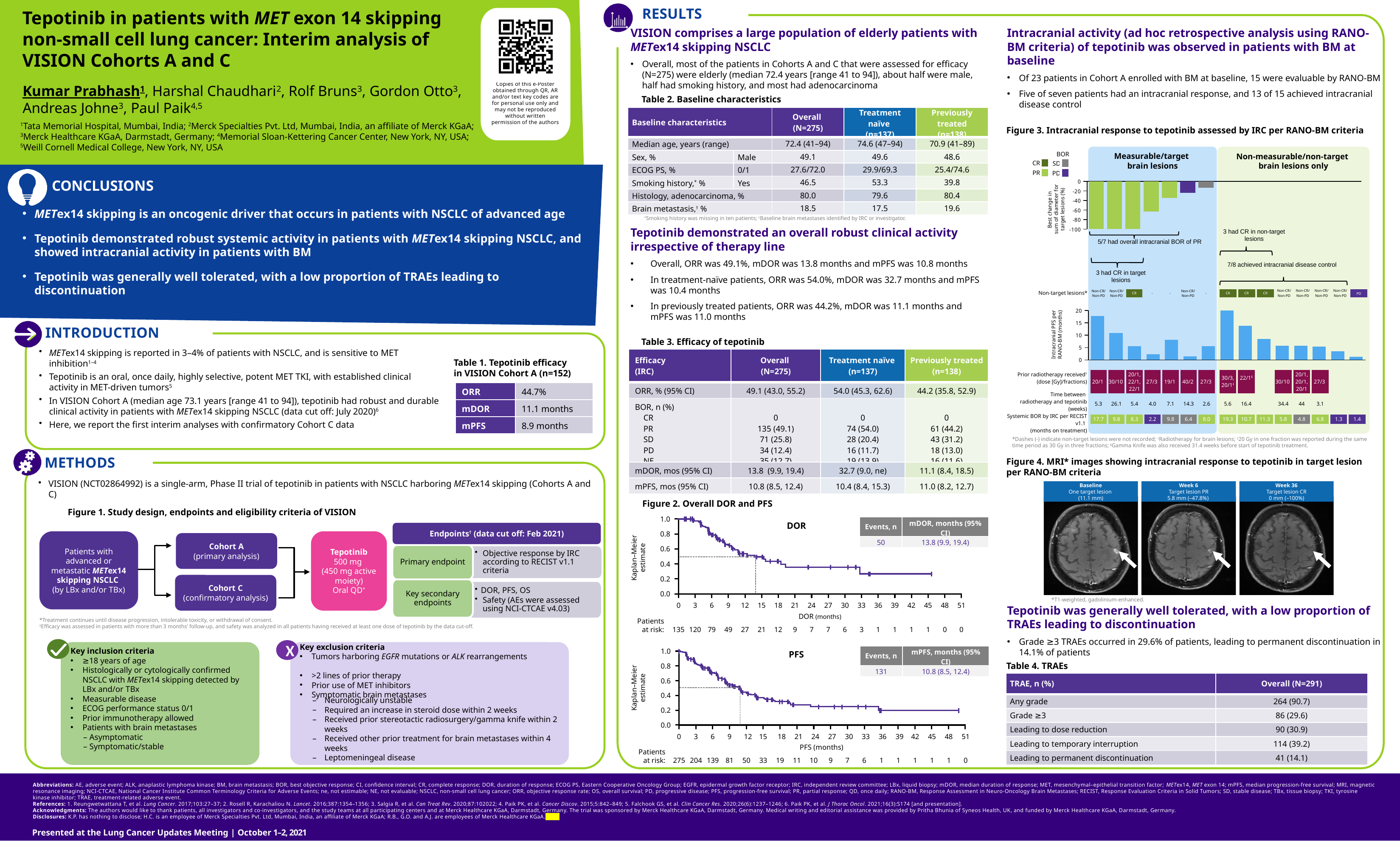
In Figure 2, how many events (n) are reported for the DOR curve? 50 In Figure 3, how many BOR categories does the legend list? 4 In Figure 2, does the PFS Kaplan-Meier estimate rise or fall as PFS months increase? fall In Figure 2, how many patients are at risk at 0 months on the PFS curve? 275 In Figure 2, what is the mPFS in months (95% CI) shown for the PFS curve? 10.8 (8.5, 12.4) In Figure 2, how many patients are at risk at 12 months on the DOR curve? 27 In Figure 2, what is the mDOR in months (95% CI) shown for the DOR curve? 13.8 (9.9, 19.4) In Figure 3, is the intracranial PFS value for the first patient in the measurable/target brain lesions group greater or less than 10 months? greater What kind of chart is the best change in sum of diameter plot in Figure 3? bar chart What kind of chart is used in Figure 2 to show DOR and PFS? Kaplan-Meier curve In Figure 2, how many events (n) are reported for the PFS curve? 131 In Figure 2, how many patients are at risk at 0 months on the DOR curve? 135